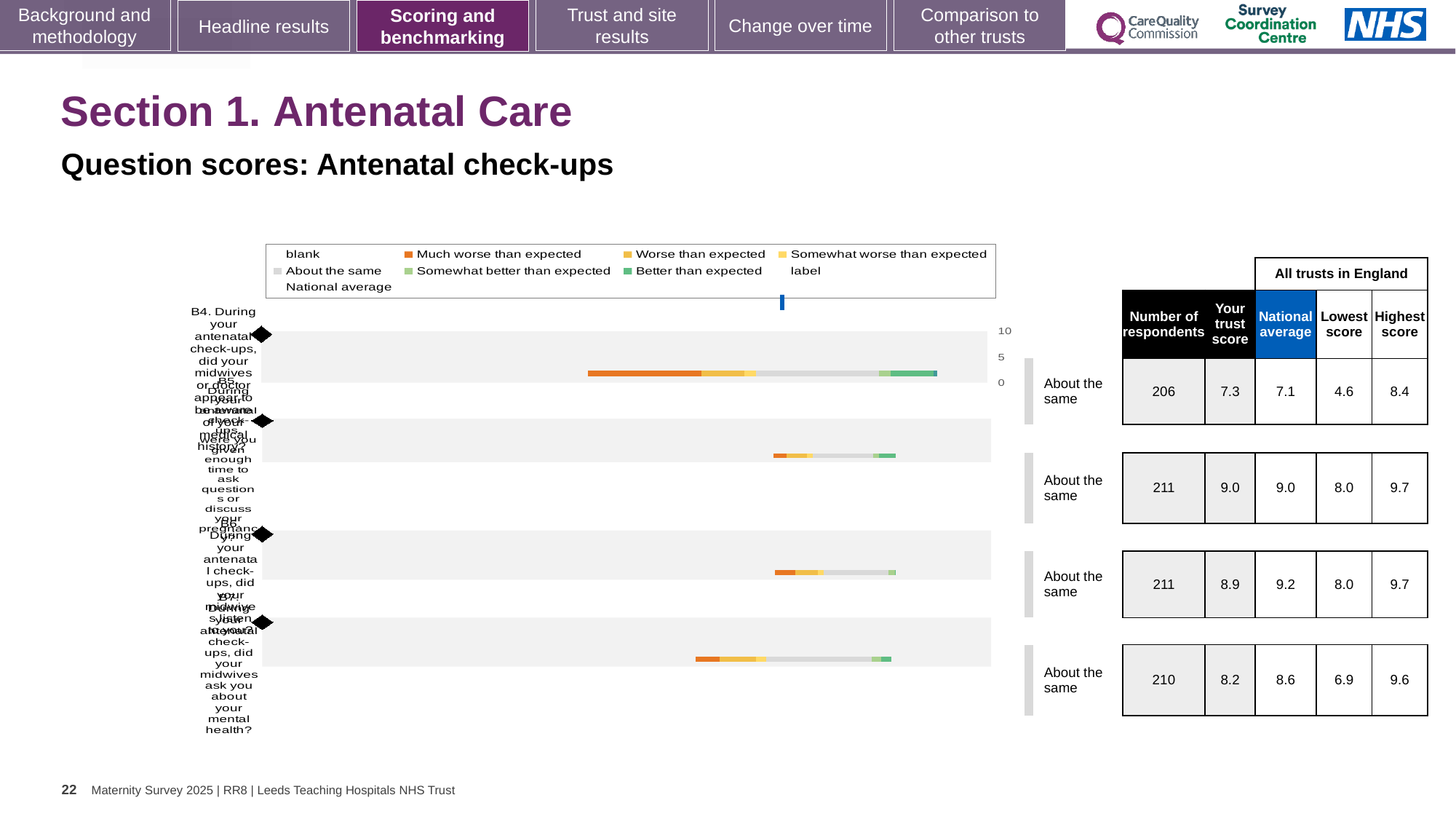
Which question code is plotted in the bottom bar of the chart? B7 What colour does the legend use for 'Better than expected'? green What is the highest tick value shown on the chart's axis? 10 What colour does the legend use for 'Much worse than expected'? orange Which question code is plotted in the top bar of the chart? B4 How many survey questions (bars) are plotted in the chart? 4 What kind of chart is shown on the slide? bar chart